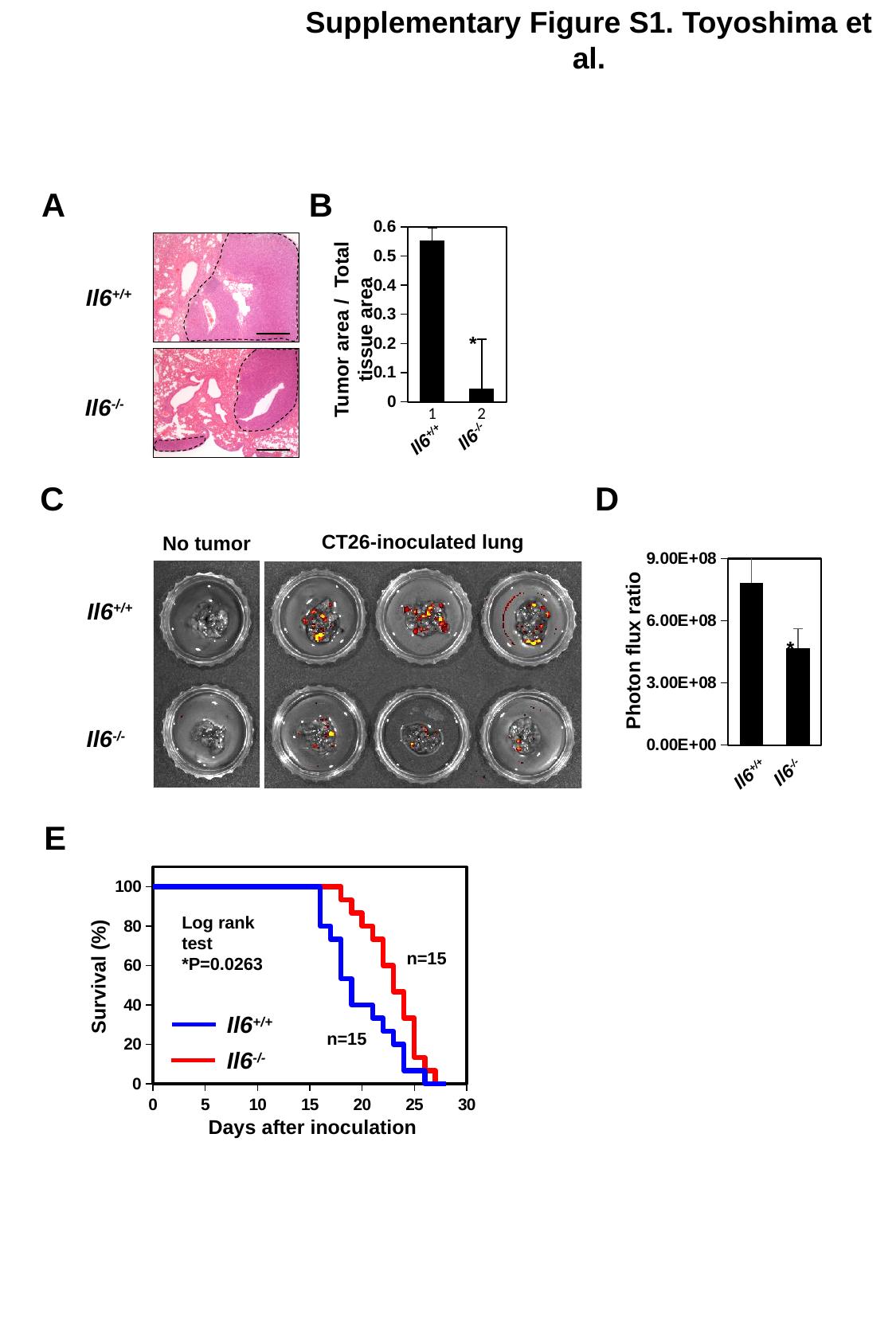
What is the y-axis label of chart D? Photon flux ratio In chart D, is the value for Il6+/+ greater or less than 6.00E+08? greater In chart E, at day 20, which group has the higher survival, Il6+/+ or Il6-/-? Il6-/- How many bars are plotted in chart B? 2 How many series does the legend of chart E list? 2 What kind of chart is chart B? bar chart In chart B, is the value for Il6-/- greater or less than 0.1? less In chart D, is the value for Il6-/- greater or less than 6.00E+08? less In chart D (Photon flux ratio), which group has the lower value? Il6-/- In chart E, does survival rise or fall as days after inoculation increase? fall In chart B (Tumor area / Total tissue area), which group has the higher value? Il6+/+